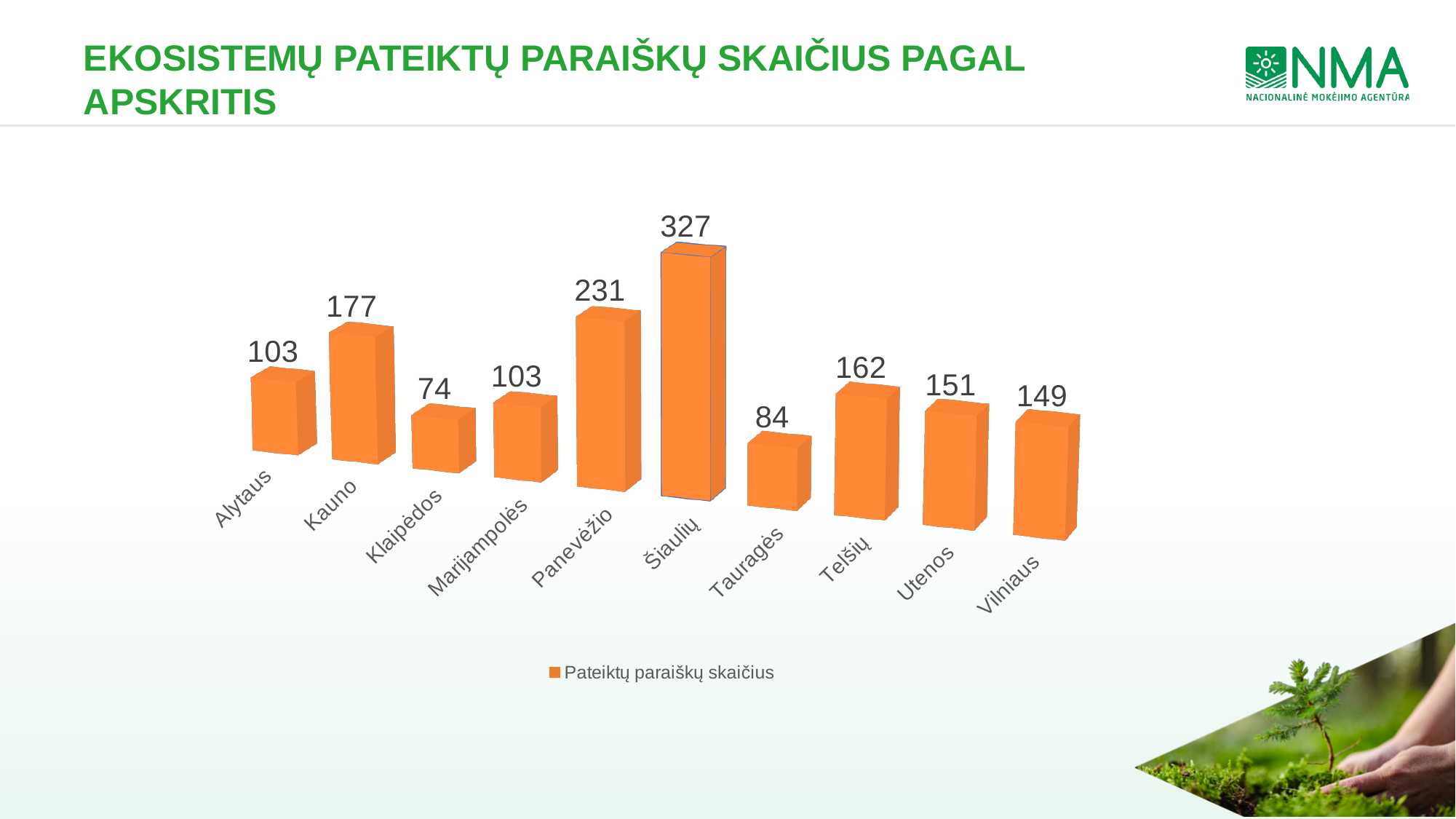
How many categories are shown on the x axis? 10 What is the value for Klaipėdos? 74 What is the legend entry for the series? Pateiktų paraiškų skaičius What is the difference between the values for Šiaulių and Panevėžio? 96 What is the difference between the values for Kauno and Alytaus? 74 What is the value for Šiaulių? 327 Which category has the lowest value? Klaipėdos What kind of chart is shown on the slide? Bar chart What is the value for Utenos? 151 Which category has the highest value? Šiaulių Which is larger, the value for Telšių or the value for Vilniaus? Telšių How many series does the legend list? 1